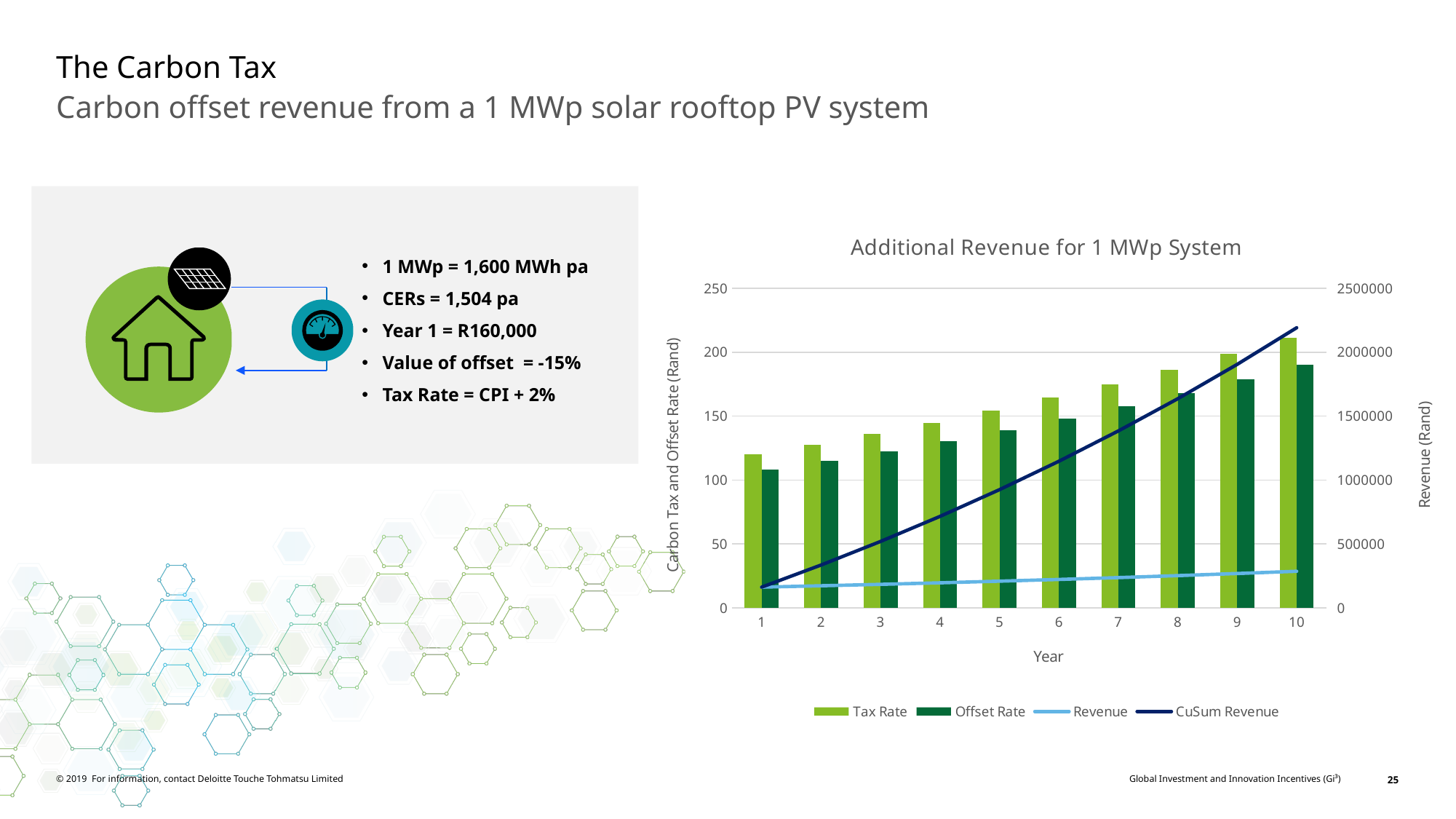
How many series does the chart's legend list? 4 In which year is the Offset Rate bar lowest? 1 In year 5, which is larger, the Tax Rate or the Offset Rate? Tax Rate How many years are shown along the x axis of the chart? 10 Is the Offset Rate value for year 5 greater or less than 150? less Which series are plotted as bars in the chart? Tax Rate and Offset Rate In which year is the Tax Rate bar highest? 10 Is the Tax Rate value for year 10 greater or less than 200? greater Is the CuSum Revenue value for year 10 greater or less than 2000000? greater What is the title of the chart on the slide? Additional Revenue for 1 MWp System What kind of chart is shown on the slide? A combined bar and line chart Does the Tax Rate rise or fall from year 1 to year 10? Rises